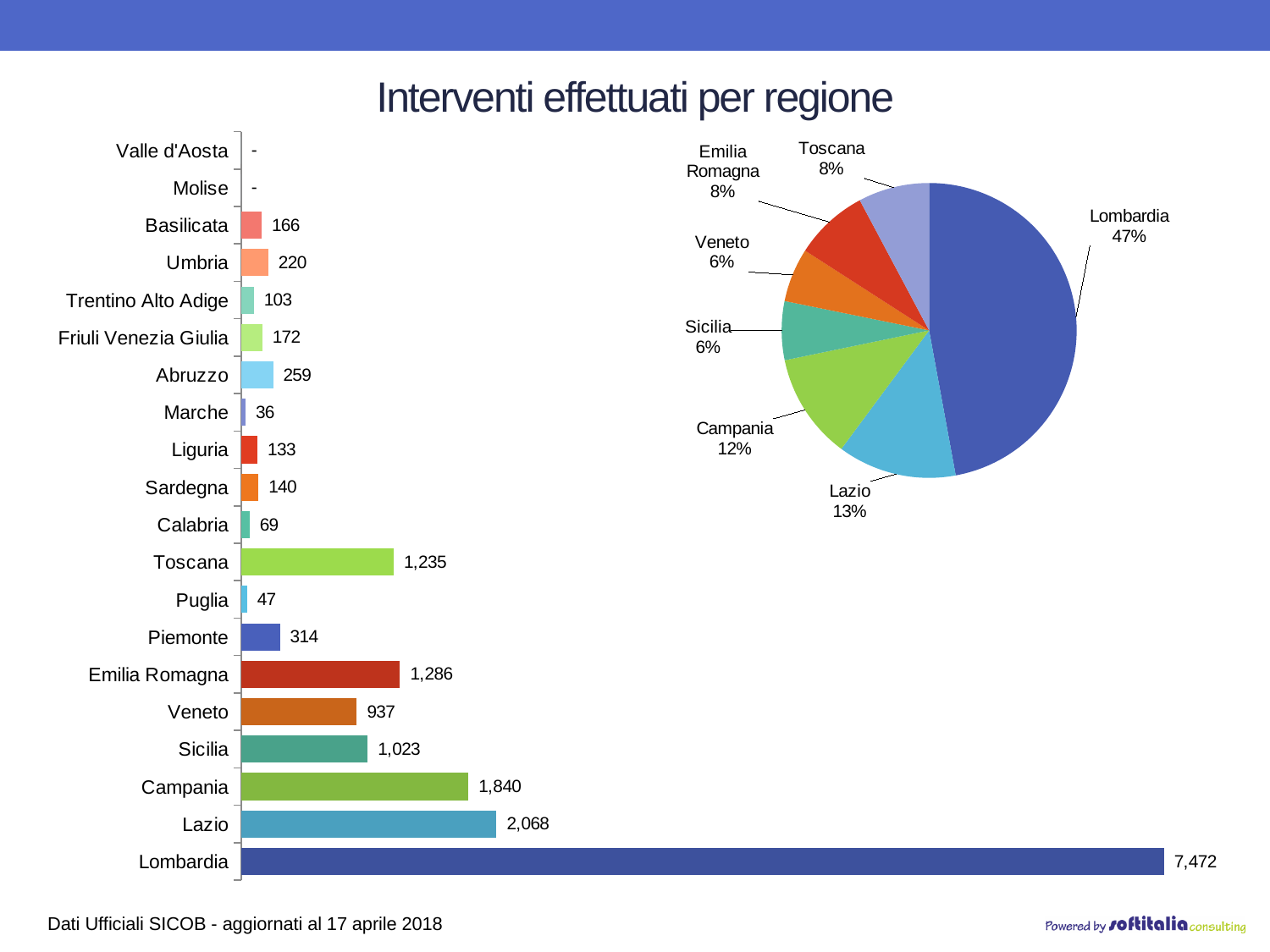
How many regions are listed in the bar chart on the left? 20 In the bar chart on the left, which is larger, the value for Emilia Romagna or the value for Toscana? Emilia Romagna In the pie chart on the right, what share does Lombardia have? 47% In the bar chart on the left, what is the value for Lombardia? 7,472 What type of chart is the chart on the left of the slide? Bar chart In the bar chart on the left, what is the value for Abruzzo? 259 In the bar chart on the left, which region has the lowest non-zero labelled value? Marche In the bar chart on the left, what is the value for Veneto? 937 In the bar chart on the left, what is the difference between the values for Lazio and Campania? 228 In the pie chart on the right, what share does Campania have? 12% How many slices does the pie chart on the right have? 7 In the bar chart on the left, which region has the highest value? Lombardia